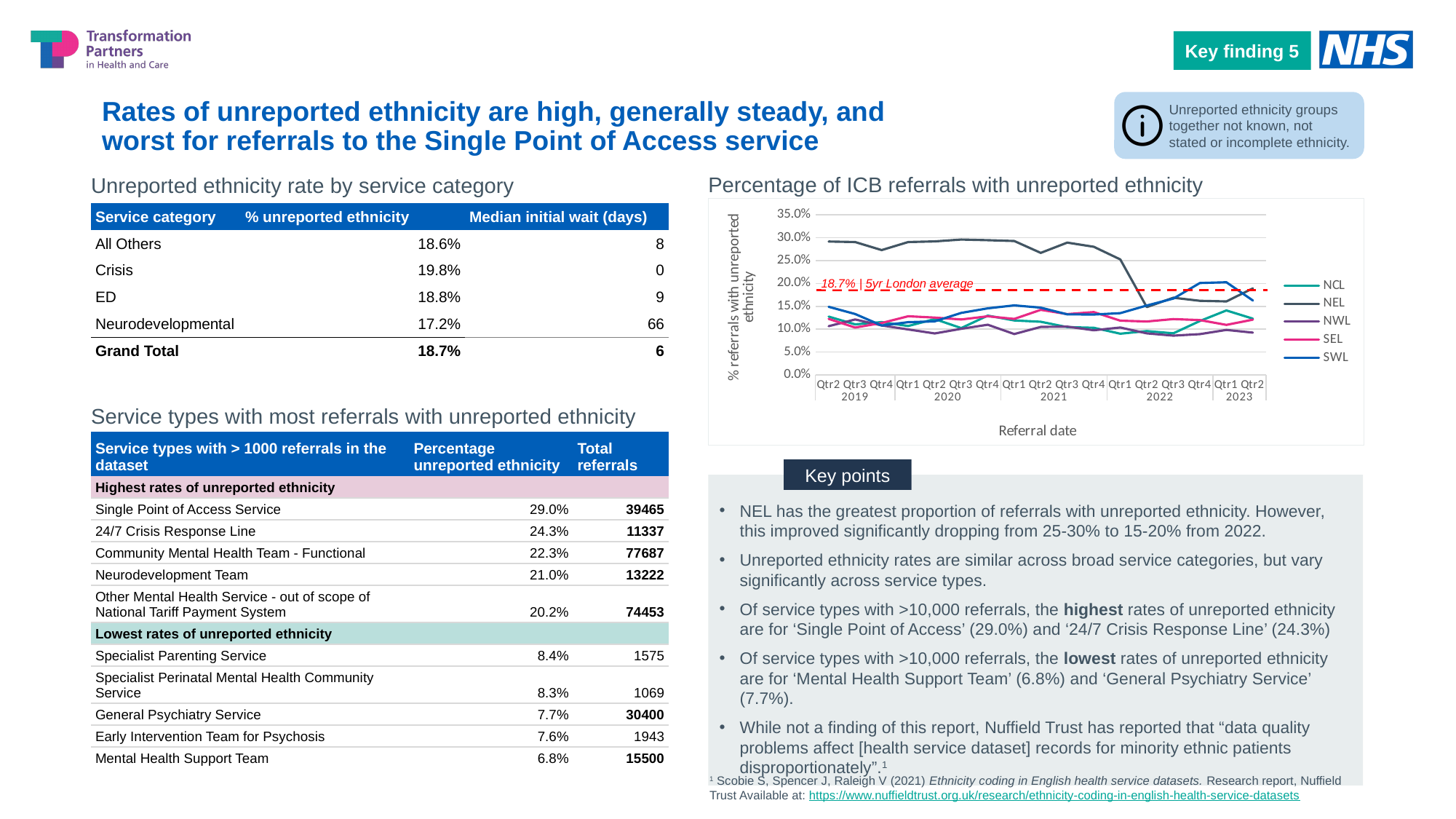
How many quarterly points are shown along the x axis of the 'Percentage of ICB referrals with unreported ethnicity' chart? 17 What value does the dashed red reference line in the 'Percentage of ICB referrals with unreported ethnicity' chart mark? 18.7% | 5yr London average In the 'Percentage of ICB referrals with unreported ethnicity' chart, which is larger in Qtr3 2020: NEL or NWL? NEL In the 'Percentage of ICB referrals with unreported ethnicity' chart, is the value for NEL in Qtr1 2020 greater or less than 25.0%? greater What is the x-axis title of the 'Percentage of ICB referrals with unreported ethnicity' chart? Referral date In the 'Percentage of ICB referrals with unreported ethnicity' chart, which series has the highest value in Qtr2 2019? NEL In the 'Percentage of ICB referrals with unreported ethnicity' chart, does the NEL series rise or fall overall from Qtr2 2019 to Qtr2 2023? fall In the 'Percentage of ICB referrals with unreported ethnicity' chart, is the value for NWL in Qtr2 2019 greater or less than 15.0%? less In the 'Percentage of ICB referrals with unreported ethnicity' chart, which series has the lowest value in Qtr2 2019? NWL How many series does the legend of the 'Percentage of ICB referrals with unreported ethnicity' chart list? 5 In the 'Percentage of ICB referrals with unreported ethnicity' chart, is the value for NEL in Qtr2 2022 greater or less than 20.0%? less What kind of chart is 'Percentage of ICB referrals with unreported ethnicity'? line chart